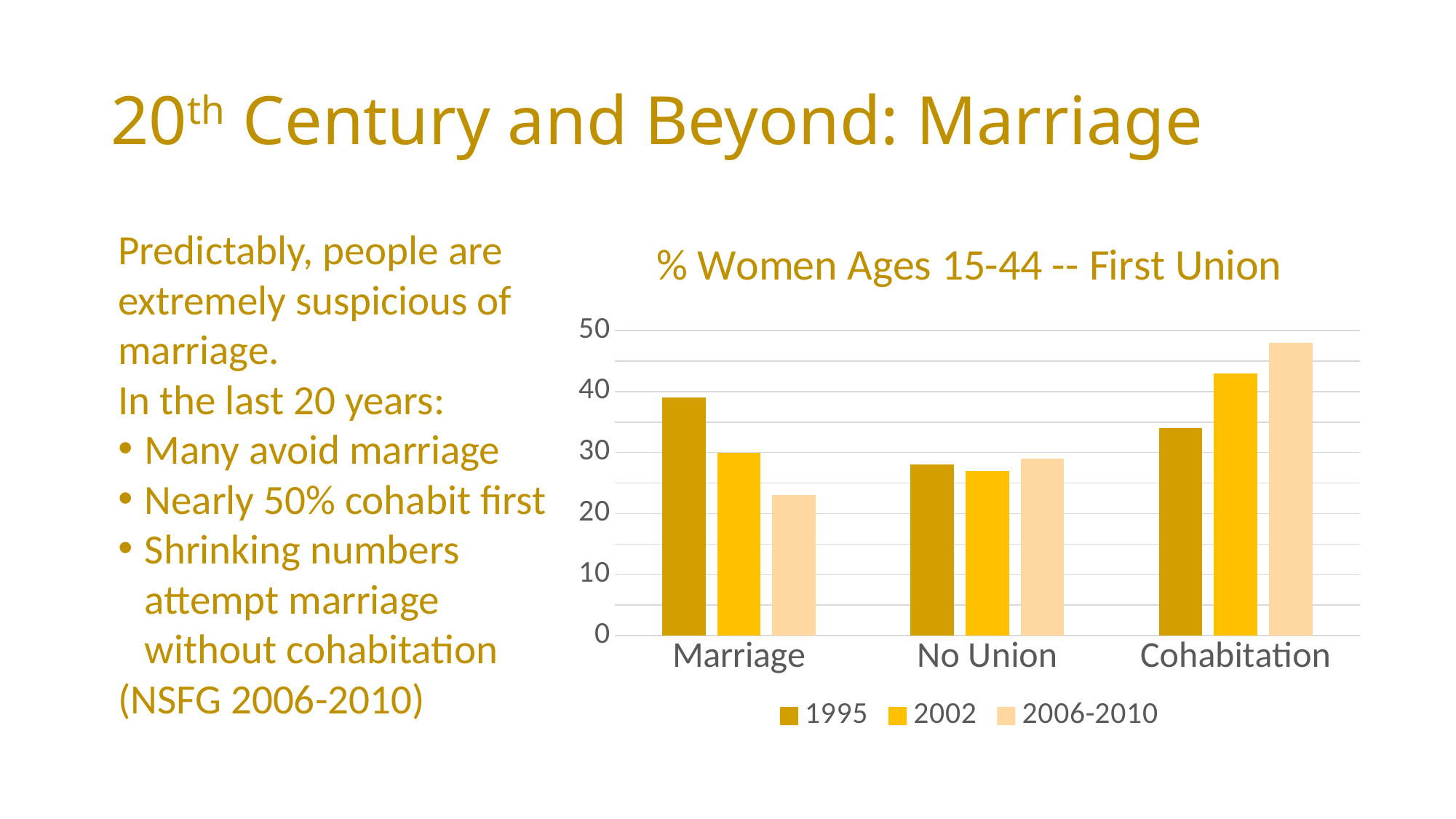
How many categories are shown on the x axis of the chart? 3 Which series has the highest value for Cohabitation? 2006-2010 Do the Marriage values rise or fall from 1995 to 2006-2010? fall Which category has the tallest bar in the chart? Cohabitation Which is larger for 2002: the value for Marriage or the value for Cohabitation? Cohabitation Is the 2006-2010 value for Marriage greater or less than 30? less Is the 2006-2010 value for Cohabitation greater or less than 40? greater How many series does the chart legend list? 3 What is the title of the chart? % Women Ages 15-44 -- First Union Is the 1995 value for Marriage greater or less than 30? greater Which series has the lowest value for Marriage? 2006-2010 What kind of chart is shown on the slide? bar chart